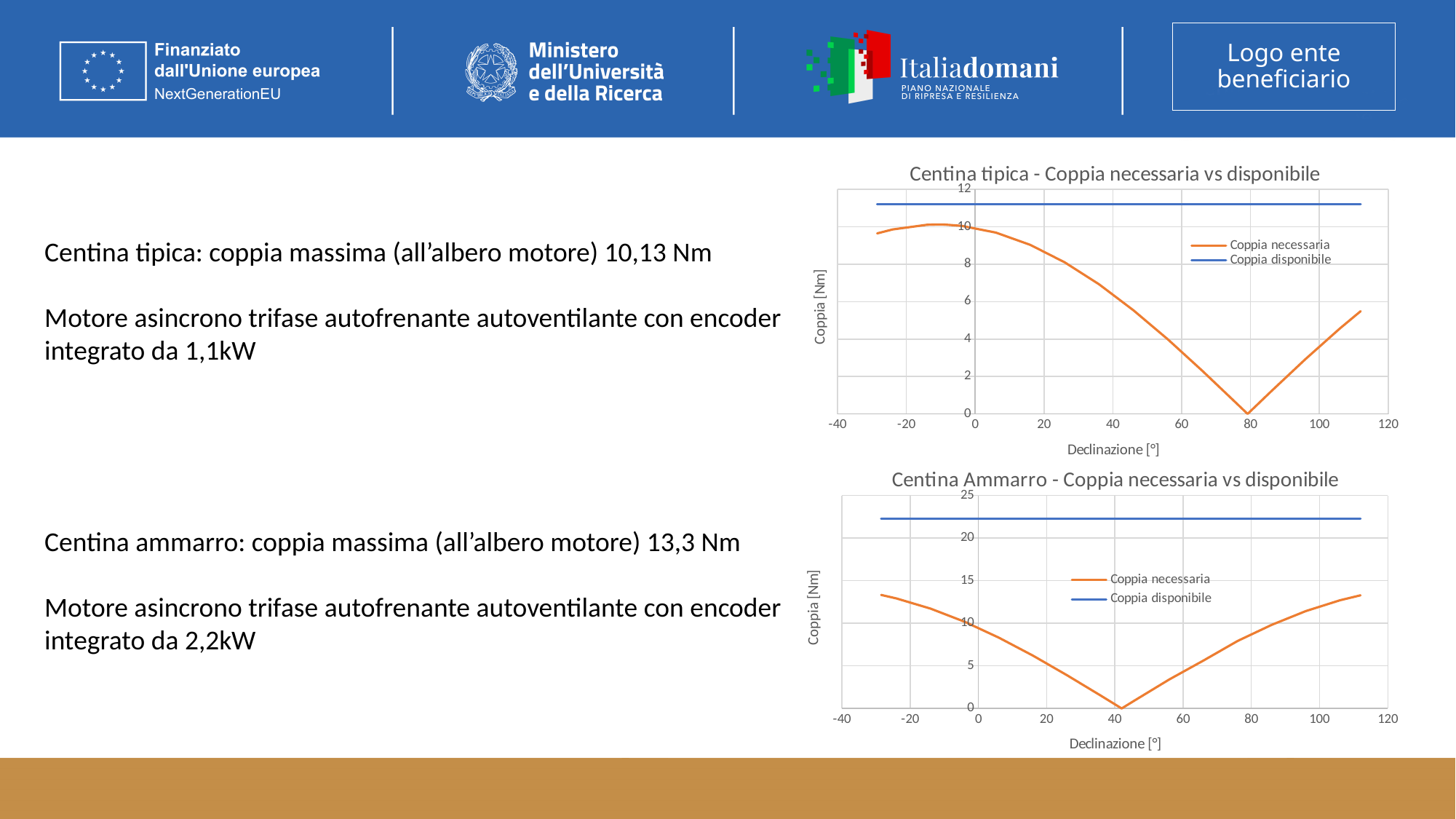
In the top chart 'Centina tipica', which series is higher at a declinazione of 40, Coppia necessaria or Coppia disponibile? Coppia disponibile What kind of chart is the top chart, 'Centina tipica - Coppia necessaria vs disponibile'? line chart In the top chart 'Centina tipica', is Coppia necessaria at a declinazione of 80 greater or less than 2? less In the bottom chart 'Centina Ammarro', is the value of Coppia disponibile greater or less than 20? greater What are the two legend entries in the bottom chart 'Centina Ammarro - Coppia necessaria vs disponibile'? Coppia necessaria, Coppia disponibile In the top chart 'Centina tipica', is Coppia necessaria at a declinazione of 0 greater or less than 8? greater In the top chart 'Centina tipica', does Coppia necessaria rise or fall as declinazione goes from 0 to 80? fall How many series does the legend of the top chart 'Centina tipica' list? 2 In the bottom chart 'Centina Ammarro', does Coppia necessaria rise or fall as declinazione goes from 40 to 100? rise What is the x-axis label of the bottom chart 'Centina Ammarro'? Declinazione [°]